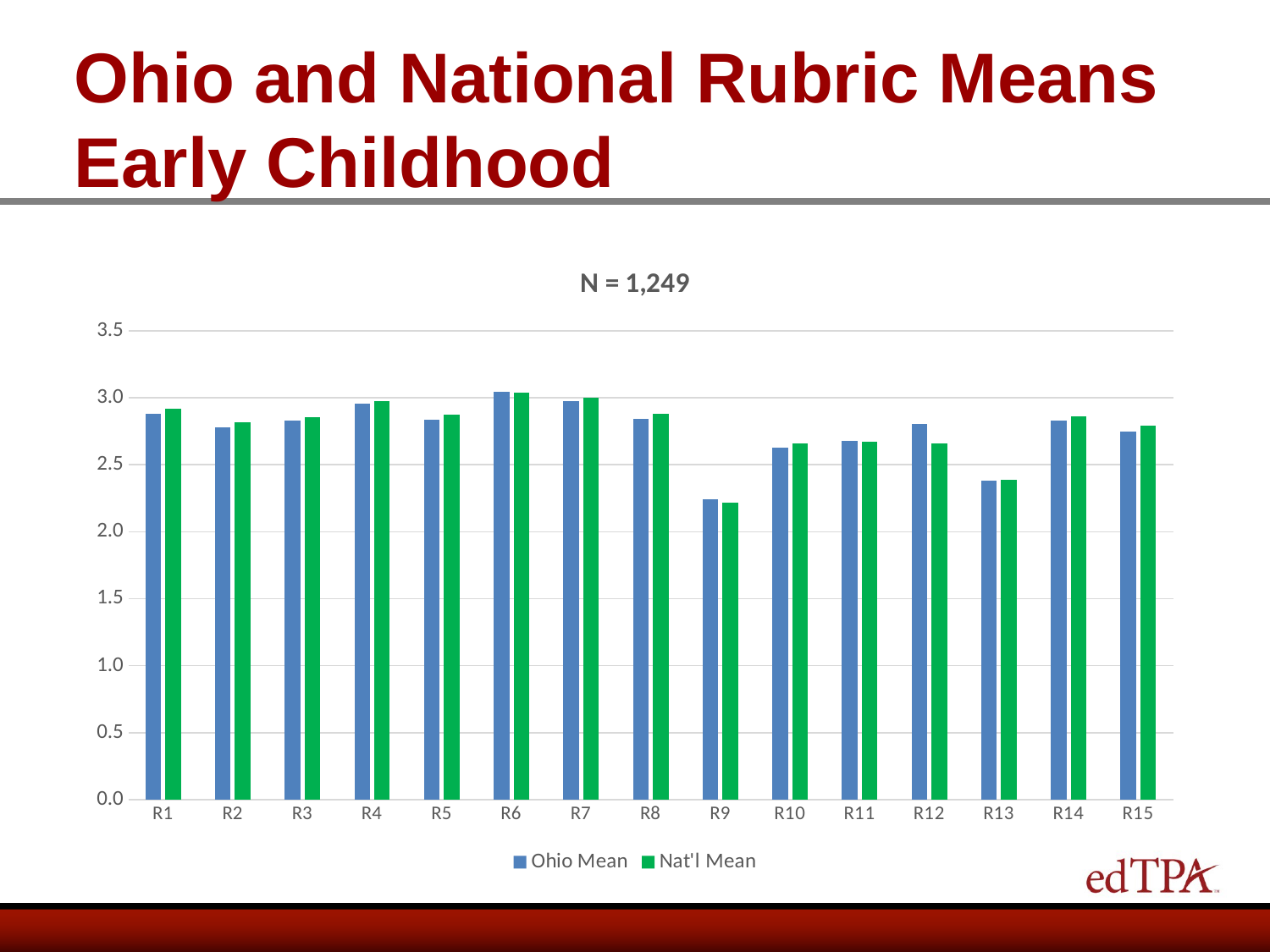
Which rubric has the highest Ohio Mean? R6 What kind of chart is shown on the slide? bar chart Is the Nat'l Mean for R13 greater or less than 2.5? less Which rubric has the lowest Ohio Mean? R9 Is the Ohio Mean for R6 greater or less than 3.0? greater How many series does the legend list? 2 What are the two series named in the legend? Ohio Mean and Nat'l Mean For R12, which is larger, the Ohio Mean or the Nat'l Mean? Ohio Mean Is the Ohio Mean for R9 greater or less than 2.5? less What is the chart title shown above the plot area? N = 1,249 Which rubric has the lowest Nat'l Mean? R9 How many rubric categories are shown on the x axis? 15